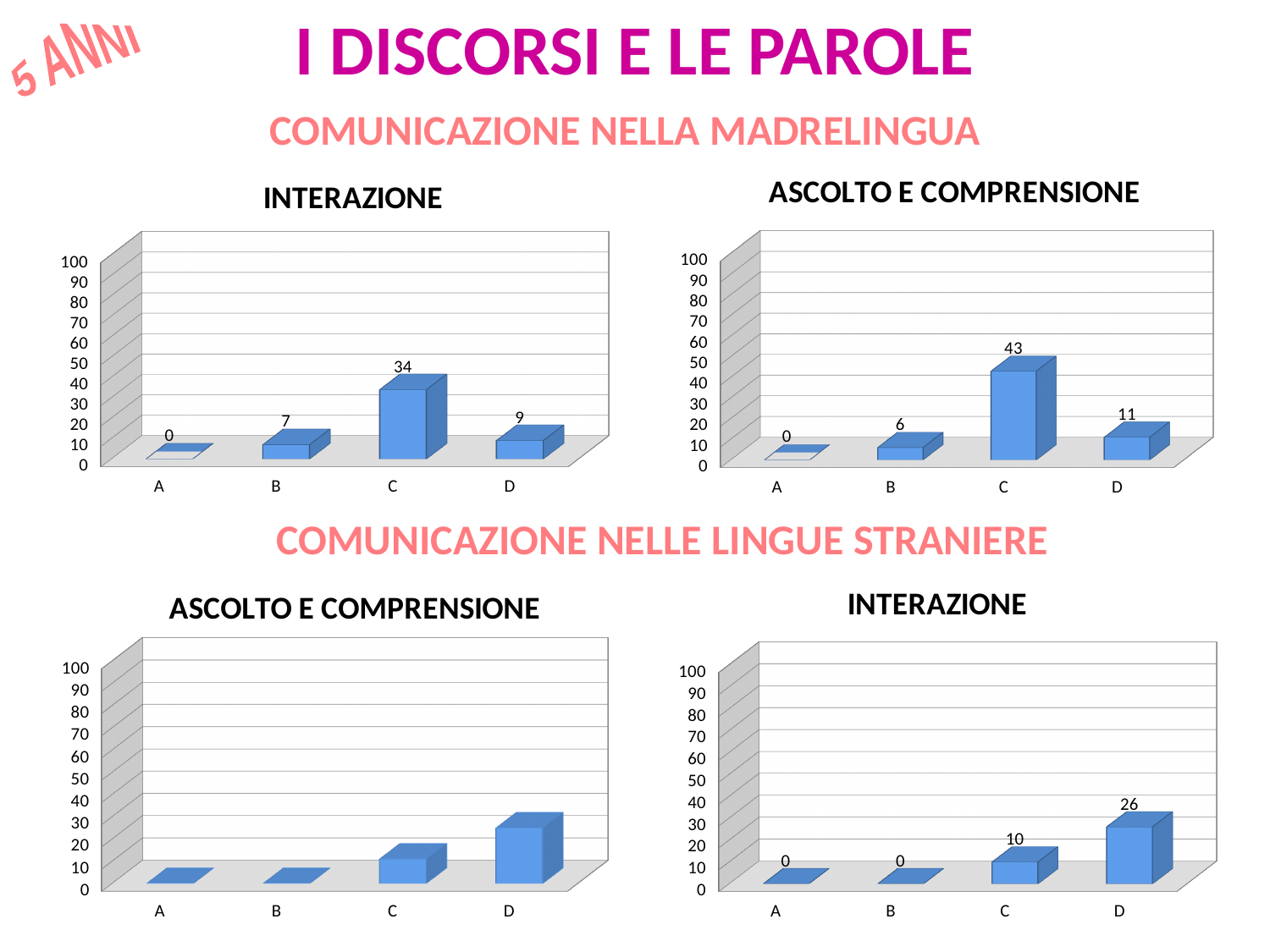
What kind of chart is the top-right chart (ASCOLTO E COMPRENSIONE under COMUNICAZIONE NELLA MADRELINGUA)? bar chart In the top-right chart (ASCOLTO E COMPRENSIONE under COMUNICAZIONE NELLA MADRELINGUA), what is the difference between the values for C and B? 37 In the top-right chart (ASCOLTO E COMPRENSIONE under COMUNICAZIONE NELLA MADRELINGUA), which category has the highest value? C In the bottom-left chart (ASCOLTO E COMPRENSIONE under COMUNICAZIONE NELLE LINGUE STRANIERE), which category has the highest value? D In the top-right chart (ASCOLTO E COMPRENSIONE under COMUNICAZIONE NELLA MADRELINGUA), what is the value for D? 11 In the top-left chart (INTERAZIONE under COMUNICAZIONE NELLA MADRELINGUA), what is the value for B? 7 In the bottom-right chart (INTERAZIONE under COMUNICAZIONE NELLE LINGUE STRANIERE), which is larger, the value for C or the value for D? D How many categories are shown on the x axis of the top-left chart (INTERAZIONE under COMUNICAZIONE NELLA MADRELINGUA)? 4 In the bottom-right chart (INTERAZIONE under COMUNICAZIONE NELLE LINGUE STRANIERE), what is the value for D? 26 In the top-left chart (INTERAZIONE under COMUNICAZIONE NELLA MADRELINGUA), is the value for C greater or less than 30? greater In the top-left chart (INTERAZIONE under COMUNICAZIONE NELLA MADRELINGUA), what is the value for C? 34 In the bottom-left chart (ASCOLTO E COMPRENSIONE under COMUNICAZIONE NELLE LINGUE STRANIERE), is the value for D greater or less than 10? greater